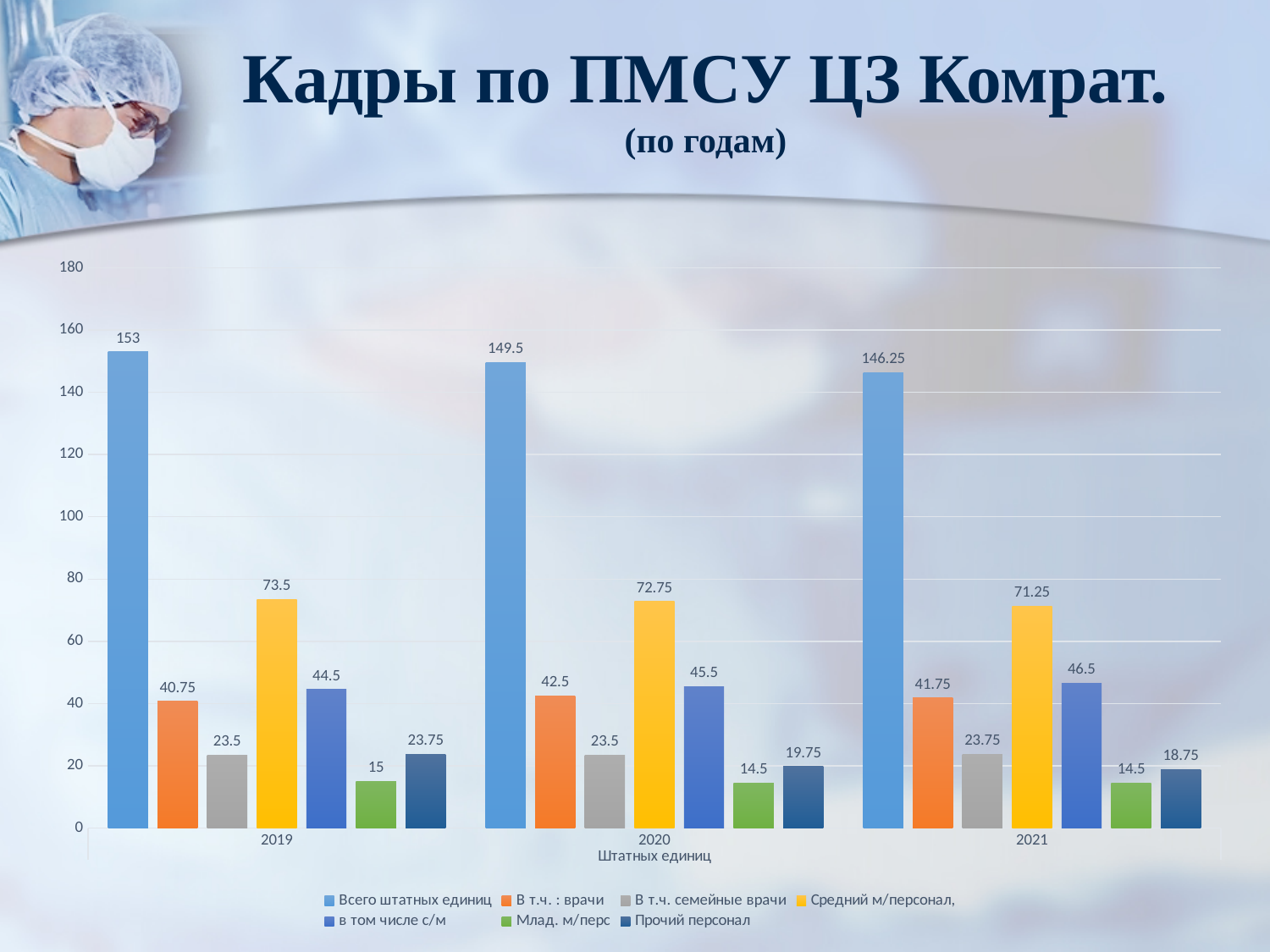
How many years are shown on the x axis? 3 In which year is "Всего штатных единиц" the highest? 2019 Does "Всего штатных единиц" rise or fall from 2019 to 2021? Fall What is the difference between "Всего штатных единиц" in 2019 and in 2021? 6.75 How many series does the legend list? 7 What is the value of "Всего штатных единиц" for 2019? 153 Which is larger: "в том числе с/м" in 2019 or in 2021? 2021 In which year is "Прочий персонал" the lowest? 2021 What is the value of "Прочий персонал" for 2020? 19.75 What kind of chart is shown on the slide? Bar chart What is the value of "Средний м/персонал" for 2021? 71.25 What is the value of "В т.ч. : врачи" for 2020? 42.5